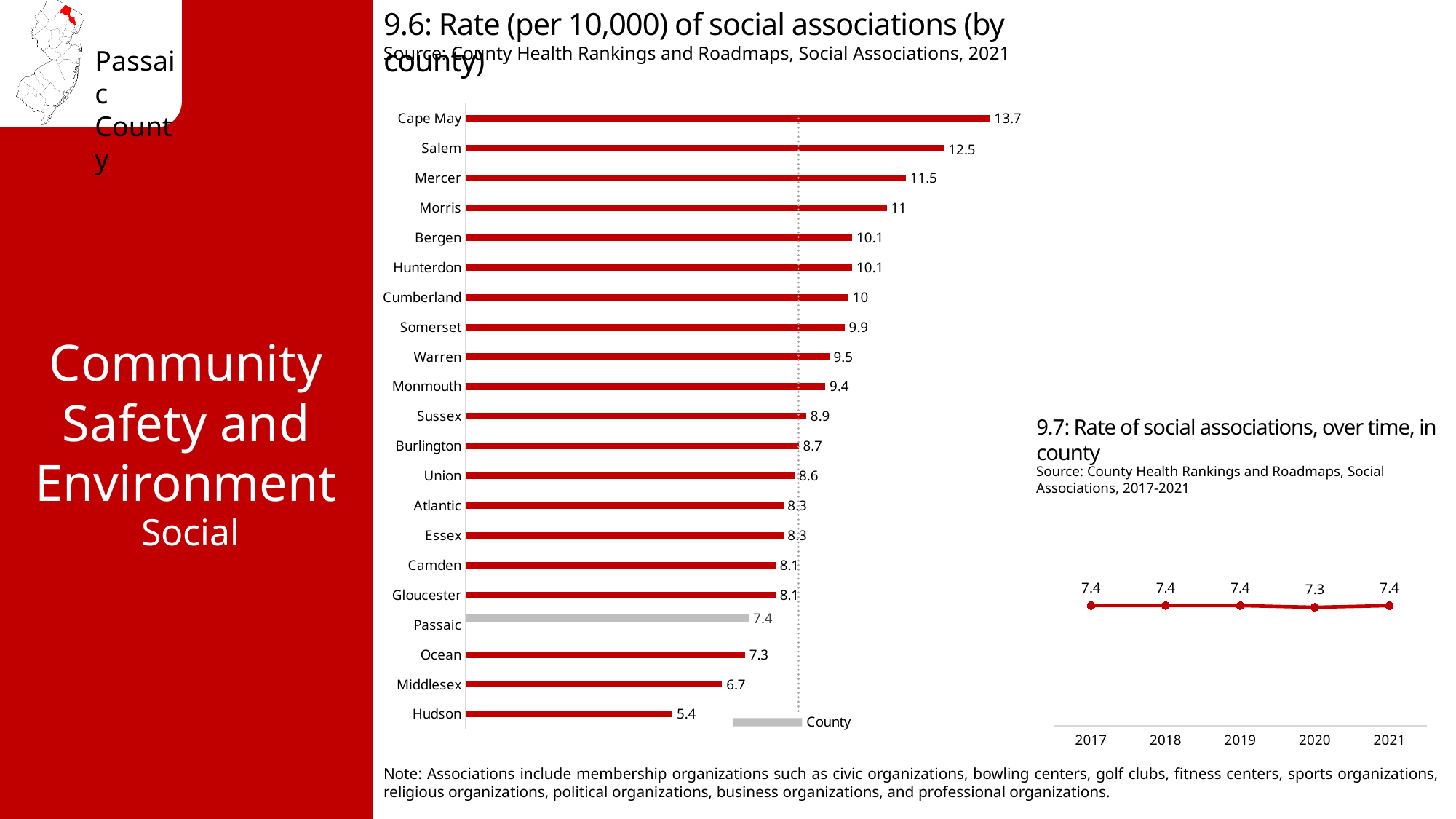
In chart 9.6 (rate of social associations by county), which is larger, the value for Salem or the value for Morris? Salem In chart 9.7 (rate of social associations over time), what is the value for 2020? 7.3 In chart 9.6 (rate of social associations by county), how many counties are shown? 21 In chart 9.6 (rate of social associations by county), which bar is shown in grey rather than red? Passaic In chart 9.6 (rate of social associations by county), what is the value for Passaic? 7.4 In chart 9.6 (rate of social associations by county), which county has the lowest rate? Hudson In chart 9.6 (rate of social associations by county), what is the value for Mercer? 11.5 In chart 9.7 (rate of social associations over time), how many years are plotted? 5 What kind of chart is chart 9.6 (rate of social associations by county)? Bar chart What kind of chart is chart 9.7 (rate of social associations over time)? Line chart In chart 9.6 (rate of social associations by county), which county has the highest rate? Cape May In chart 9.6 (rate of social associations by county), what is the difference between Cape May and Hudson? 8.3